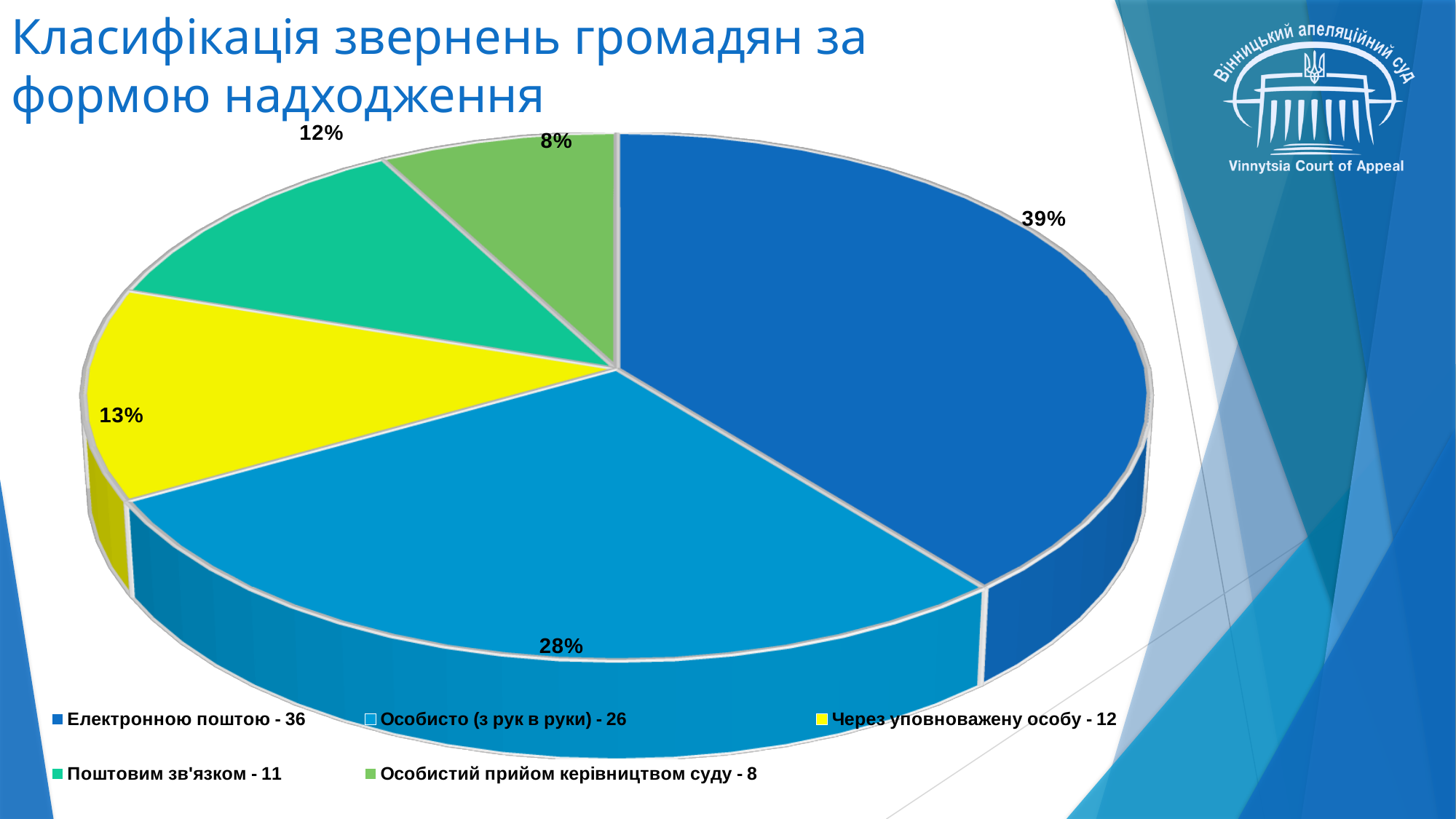
What percentage share is shown for the slice "Особистий прийом керівництвом суду - 8"? 8% What kind of chart is shown on the slide? pie chart What percentage share is shown for the slice "Електронною поштою - 36"? 39% Which category has the smallest share of the pie? Особистий прийом керівництвом суду - 8 What is the difference in percentage points between the "Електронною поштою" slice and the "Особисто (з рук в руки)" slice? 11 What percentage share is shown for the slice "Особисто (з рук в руки) - 26"? 28% Which category has the largest share of the pie? Електронною поштою - 36 What is the title of the slide containing the pie chart? Класифікація звернень громадян за формою надходження How many slices does the pie chart have? 5 Which slice is larger: "Через уповноважену особу" or "Поштовим зв'язком"? Через уповноважену особу